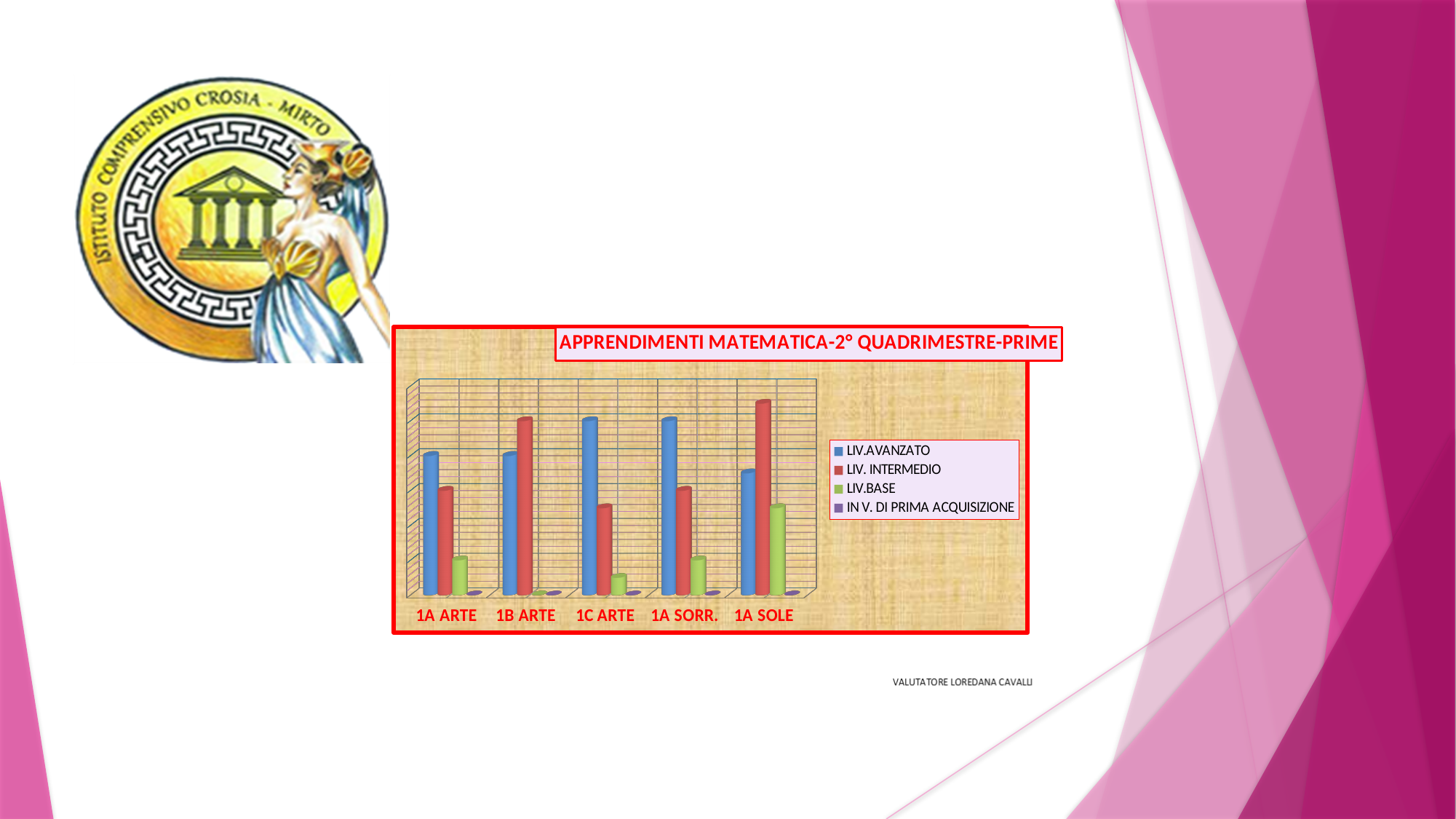
For 1A ARTE, which is larger: LIV.AVANZATO or LIV. INTERMEDIO? LIV.AVANZATO How many series does the chart's legend list? 4 For 1B ARTE, which is larger: LIV. INTERMEDIO or LIV.AVANZATO? LIV. INTERMEDIO Which class has the tallest LIV. INTERMEDIO bar? 1A SOLE Which class has the lowest LIV. INTERMEDIO bar? 1C ARTE What kind of chart is shown on the slide? bar chart Which class has the lowest LIV.AVANZATO bar? 1A SOLE How many classes (categories) are shown on the x axis of the chart? 5 For 1A SOLE, which level has the tallest bar? LIV. INTERMEDIO For 1C ARTE, which level has the tallest bar? LIV.AVANZATO What is the title of the chart? APPRENDIMENTI MATEMATICA-2° QUADRIMESTRE-PRIME